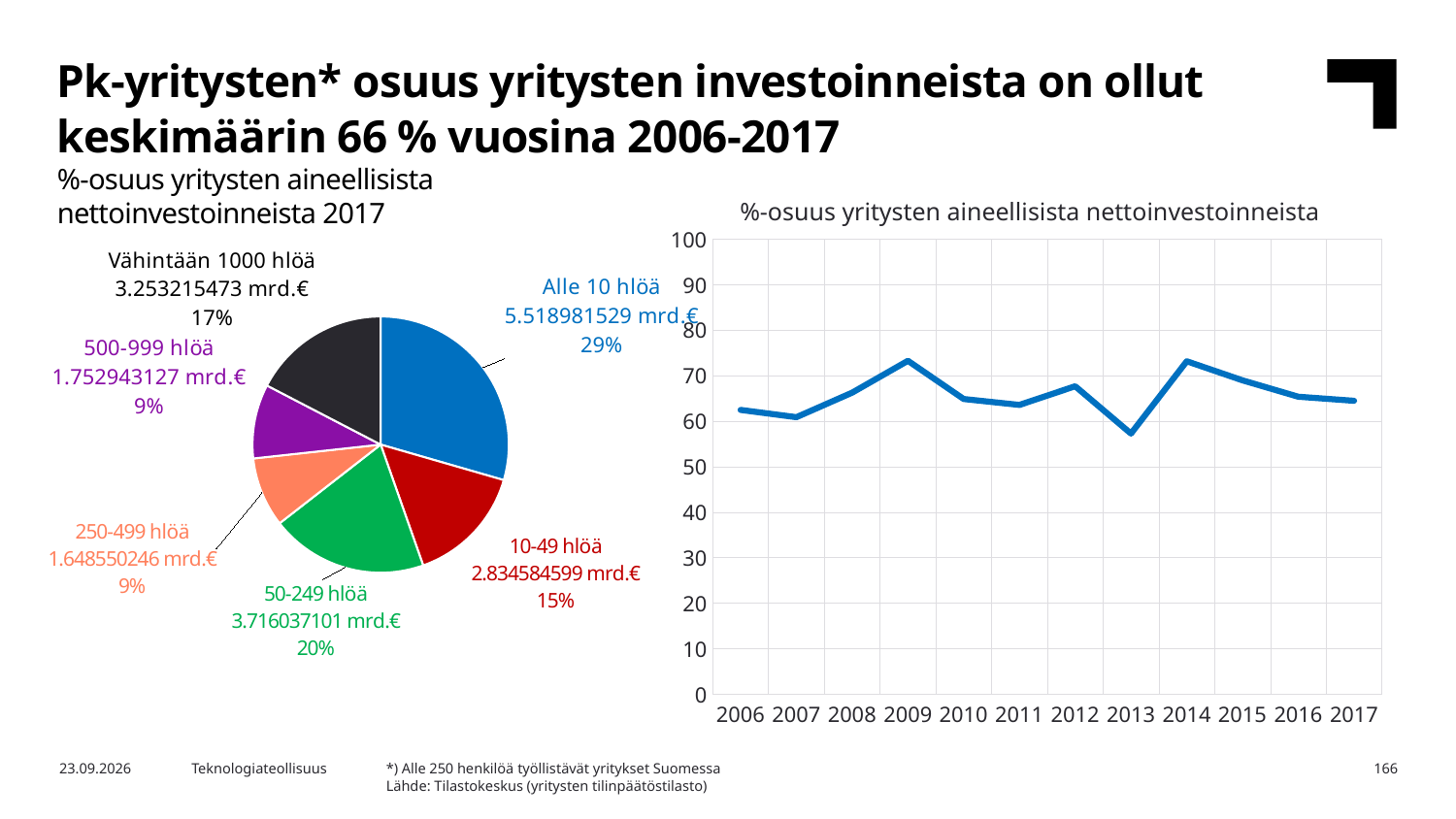
In the line chart on the right, is the value for 2013 greater or less than 60? less What type of chart is the chart on the right of the slide? Line chart In the pie chart on the left, which has the larger share, '10-49 hlöä' or '50-249 hlöä'? 50-249 hlöä In the pie chart on the left, what share of net investments is attributed to 'Alle 10 hlöä'? 29% In the line chart on the right, is the value for 2009 greater or less than 70? greater In the pie chart on the left, what is the difference in percentage points between the shares of 'Alle 10 hlöä' and '10-49 hlöä'? 14 percentage points In the line chart on the right, which year has the lowest value? 2013 In the pie chart on the left, which category has the largest share? Alle 10 hlöä How many years are plotted in the line chart on the right? 12 In the pie chart on the left, what share is shown for 'Vähintään 1000 hlöä'? 17% How many slices does the pie chart on the left have? 6 In the pie chart on the left, what is the value in mrd.€ for '50-249 hlöä'? 3.716037101 mrd.€